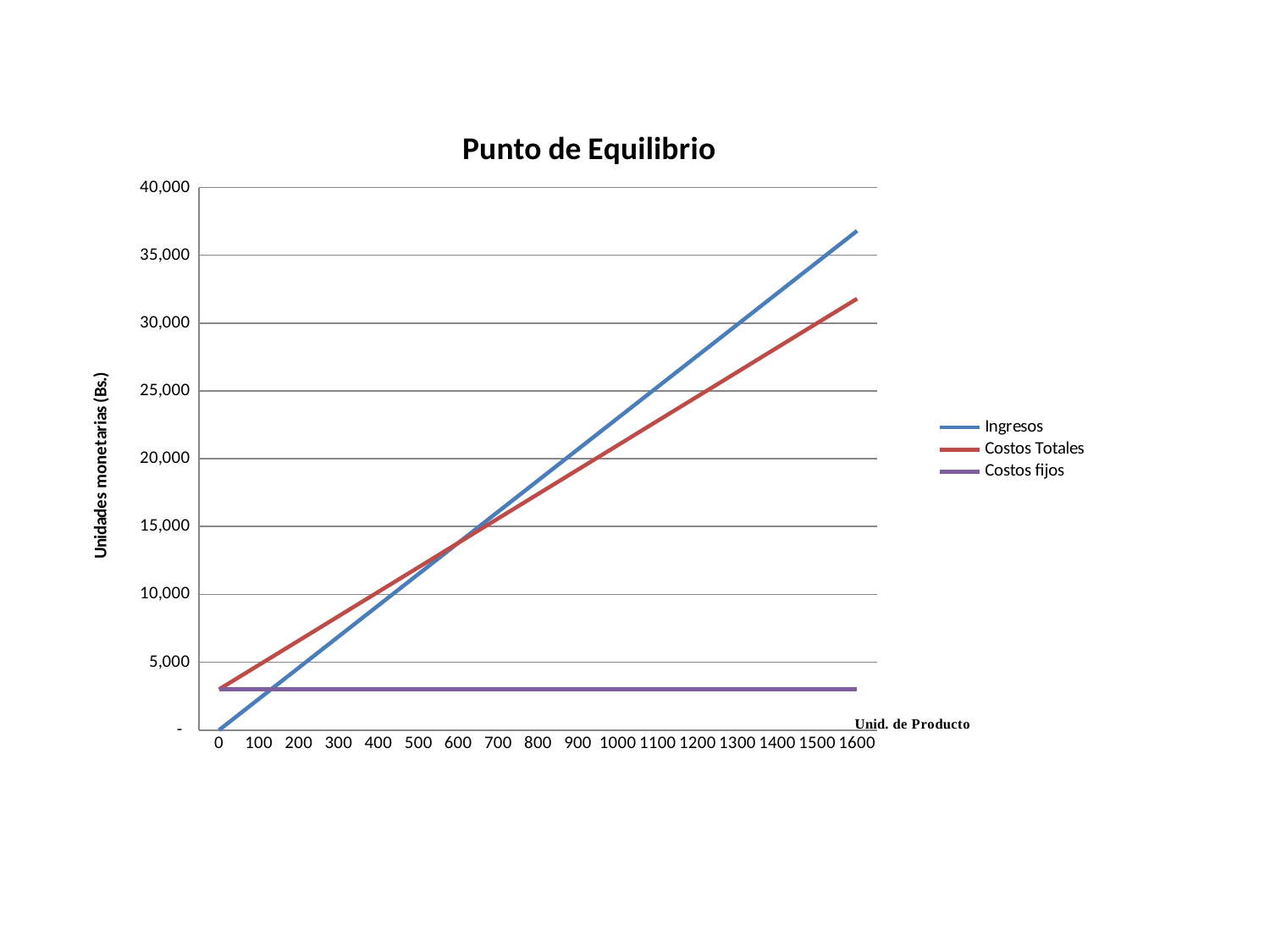
Which series has the highest value at 1600 units? Ingresos Is the value of Ingresos at 800 units greater or less than 20,000? less Which series is drawn as a flat horizontal line? Costos fijos Is the value of Ingresos at 1600 units greater or less than 35,000? greater Is the value of Costos fijos greater or less than 5,000? less At 200 units, which is larger: Ingresos or Costos Totales? Costos Totales Does the Ingresos line rise or fall as the units of product increase along the x axis? rise How many series does the legend list? 3 At 1600 units, which is larger: Ingresos or Costos Totales? Ingresos What is the title of the chart? Punto de Equilibrio What kind of chart is shown on the slide? line chart